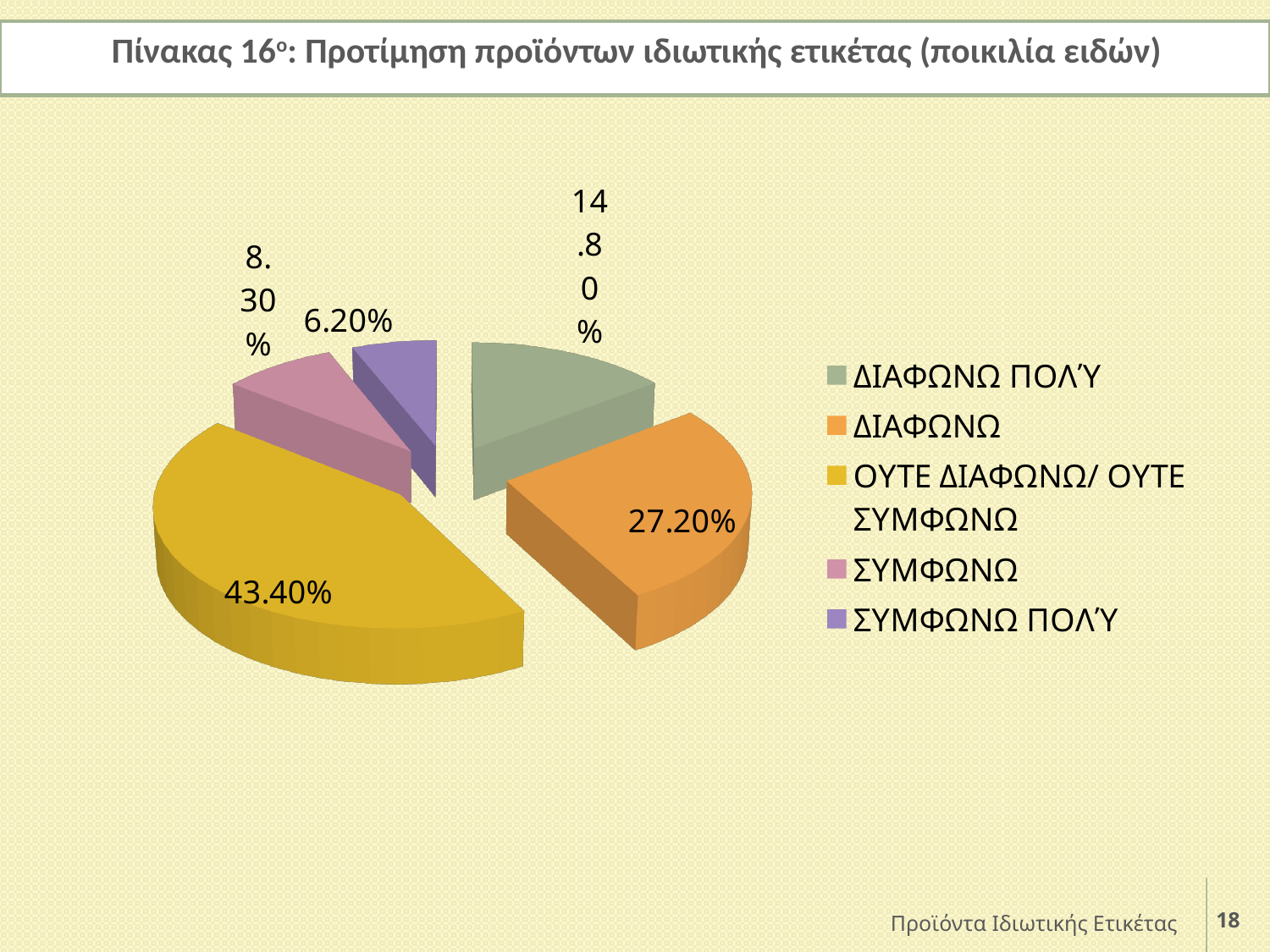
Which category has the largest slice of the pie? ΟΥΤΕ ΔΙΑΦΩΝΩ/ ΟΥΤΕ ΣΥΜΦΩΝΩ What percentage is shown for ΔΙΑΦΩΝΩ? 27.20% How many categories does the pie chart have? 5 What percentage is shown for ΣΥΜΦΩΝΩ? 8.30% What kind of chart is shown on the slide? pie chart What percentage is shown for ΟΥΤΕ ΔΙΑΦΩΝΩ/ ΟΥΤΕ ΣΥΜΦΩΝΩ? 43.40% What percentage is shown for ΣΥΜΦΩΝΩ ΠΟΛΎ? 6.20% Which is larger, the slice for ΔΙΑΦΩΝΩ ΠΟΛΎ or the slice for ΣΥΜΦΩΝΩ? ΔΙΑΦΩΝΩ ΠΟΛΎ What is the title of the chart on the slide? Πίνακας 16ο: Προτίμηση προϊόντων ιδιωτικής ετικέτας (ποικιλία ειδών) What percentage is shown for ΔΙΑΦΩΝΩ ΠΟΛΎ? 14.80% Which category has the smallest slice of the pie? ΣΥΜΦΩΝΩ ΠΟΛΎ What is the difference in percentage points between ΟΥΤΕ ΔΙΑΦΩΝΩ/ ΟΥΤΕ ΣΥΜΦΩΝΩ and ΔΙΑΦΩΝΩ? 16.20%